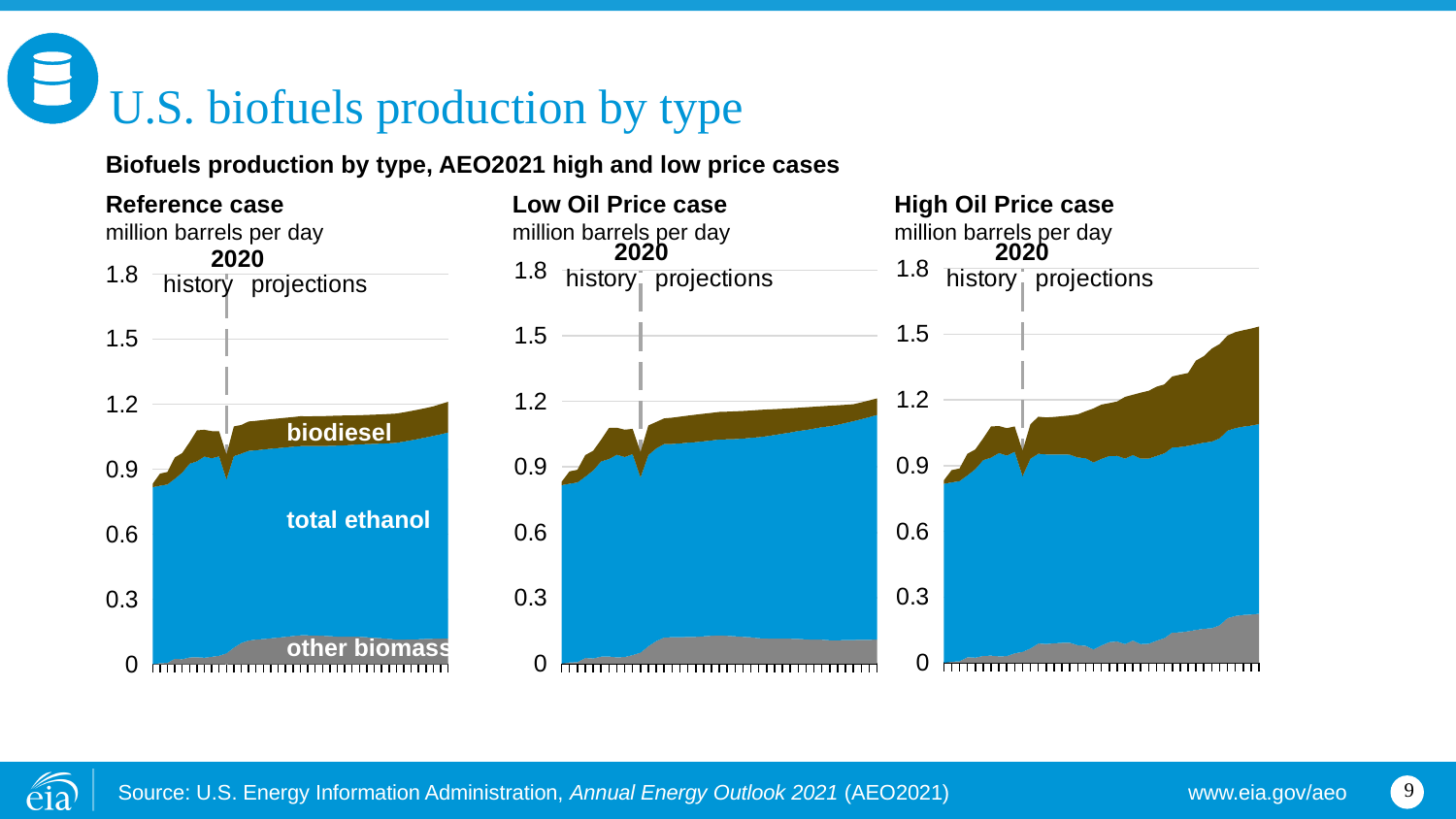
What kind of chart is the Reference case chart? stacked area chart In the High Oil Price case chart, is the biodiesel layer at the end of the projection period larger or smaller than in the Low Oil Price case chart? larger In the Reference case chart, which series forms the bottom layer of the stack? other biomass In the Reference case chart, is the total biofuels production at the end of the projection period greater or less than 0.9 million barrels per day? greater How many biofuel types are shown as series in the Reference case chart? 3 In the High Oil Price case chart, does total biofuels production rise or fall over the projection period? rise In the Reference case chart, is the total biofuels production at the start of the history period greater or less than 1.2 million barrels per day? less What unit is used on the y axis of all three charts? million barrels per day Which of the three cases shows the highest total biofuels production at the end of the projection period? High Oil Price case In the Low Oil Price case chart, is the total biofuels production at the end of the projection period greater or less than 1.5 million barrels per day? less In the Reference case chart, which series is shown in blue? total ethanol